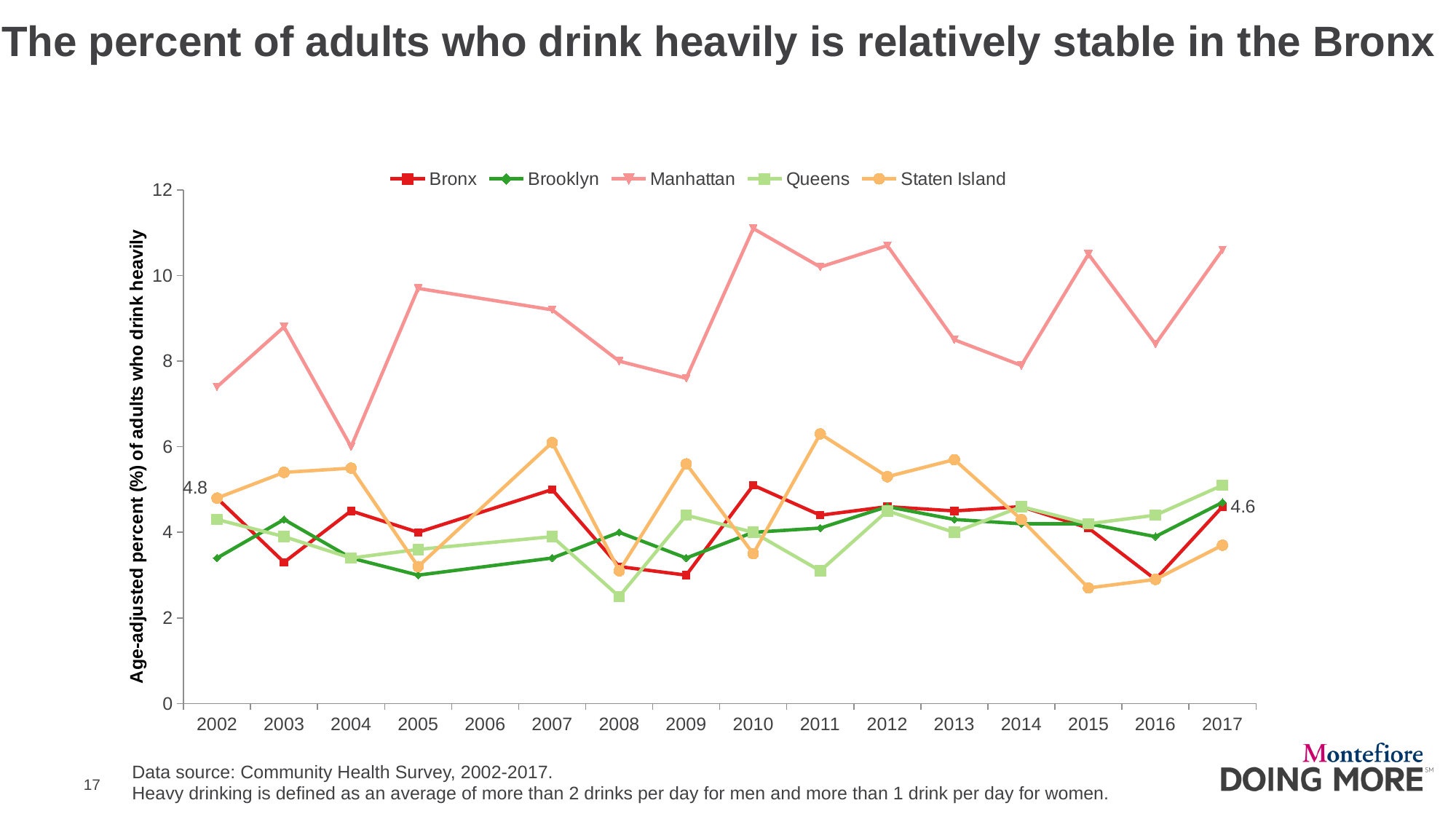
Which is larger for the Bronx: the 2002 value or the 2017 value? 2002 What is the labeled value for the Bronx in 2002? 4.8 What kind of chart is shown on the slide? Line chart What is the labeled value for the Bronx in 2017? 4.6 What is the difference between the Bronx's labeled values in 2002 and 2017? 0.2 Which borough has the lowest value in 2008? Queens What is the title of the slide? The percent of adults who drink heavily is relatively stable in the Bronx Is the value for Queens in 2008 greater or less than 4? less Is the value for Manhattan in 2010 greater or less than 10? greater Which borough has the highest value in 2010? Manhattan How many series does the legend list? 5 How many years are labeled on the x axis? 16